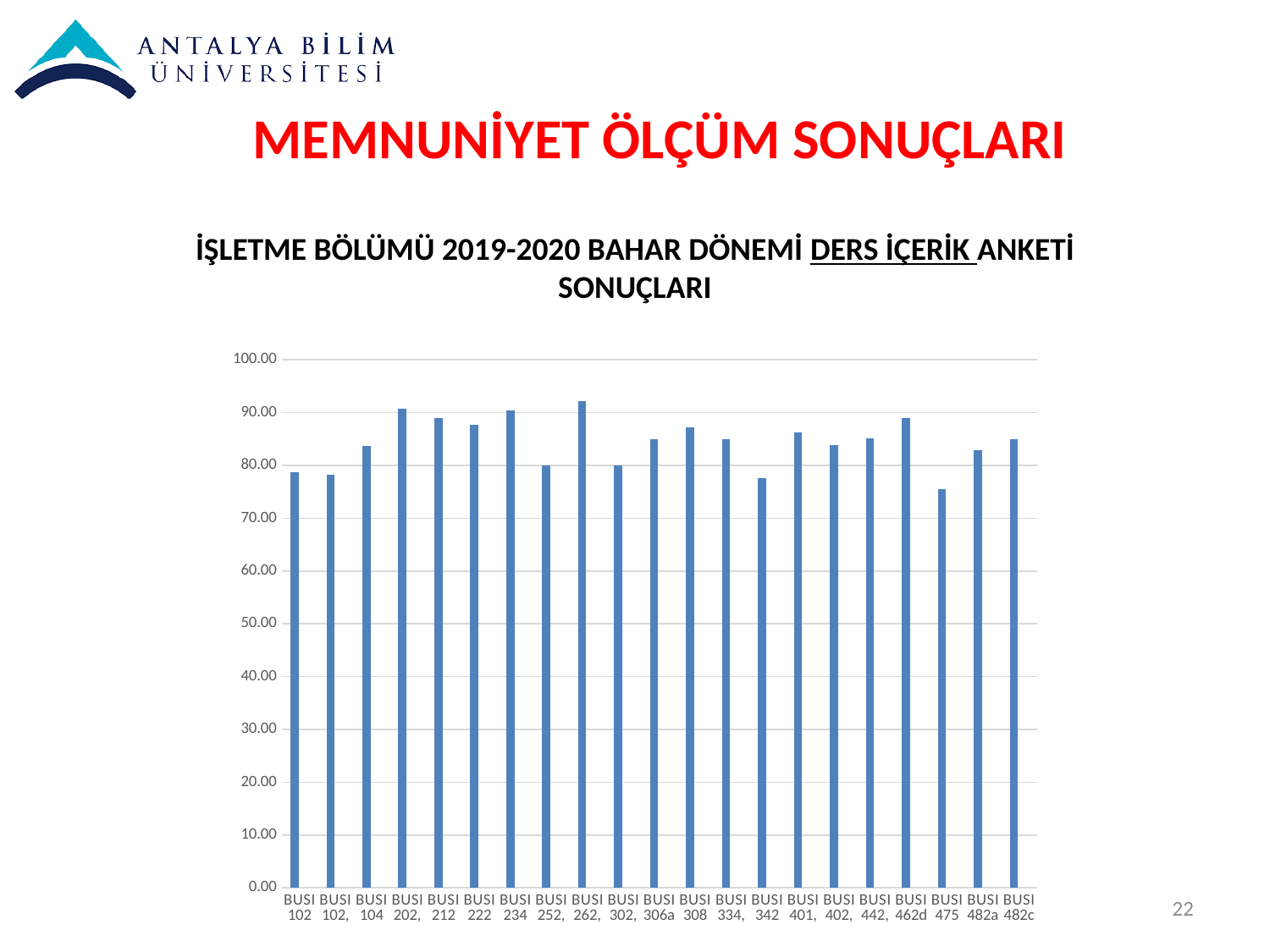
What is the highest value shown on the vertical axis of the chart? 100.00 Is the value for BUSI 475 greater or less than 80? less Which has the larger value, BUSI 202 or BUSI 342? BUSI 202 Is the value for BUSI 462d greater or less than 80? greater What kind of chart is shown on the slide? bar chart Which has the larger value, BUSI 262 or BUSI 475? BUSI 262 Is the value for BUSI 262 greater or less than 90? greater Which has the larger value, BUSI 222 or BUSI 104? BUSI 222 How many bars (courses) are plotted in the chart? 21 What colour are the bars in the chart? blue